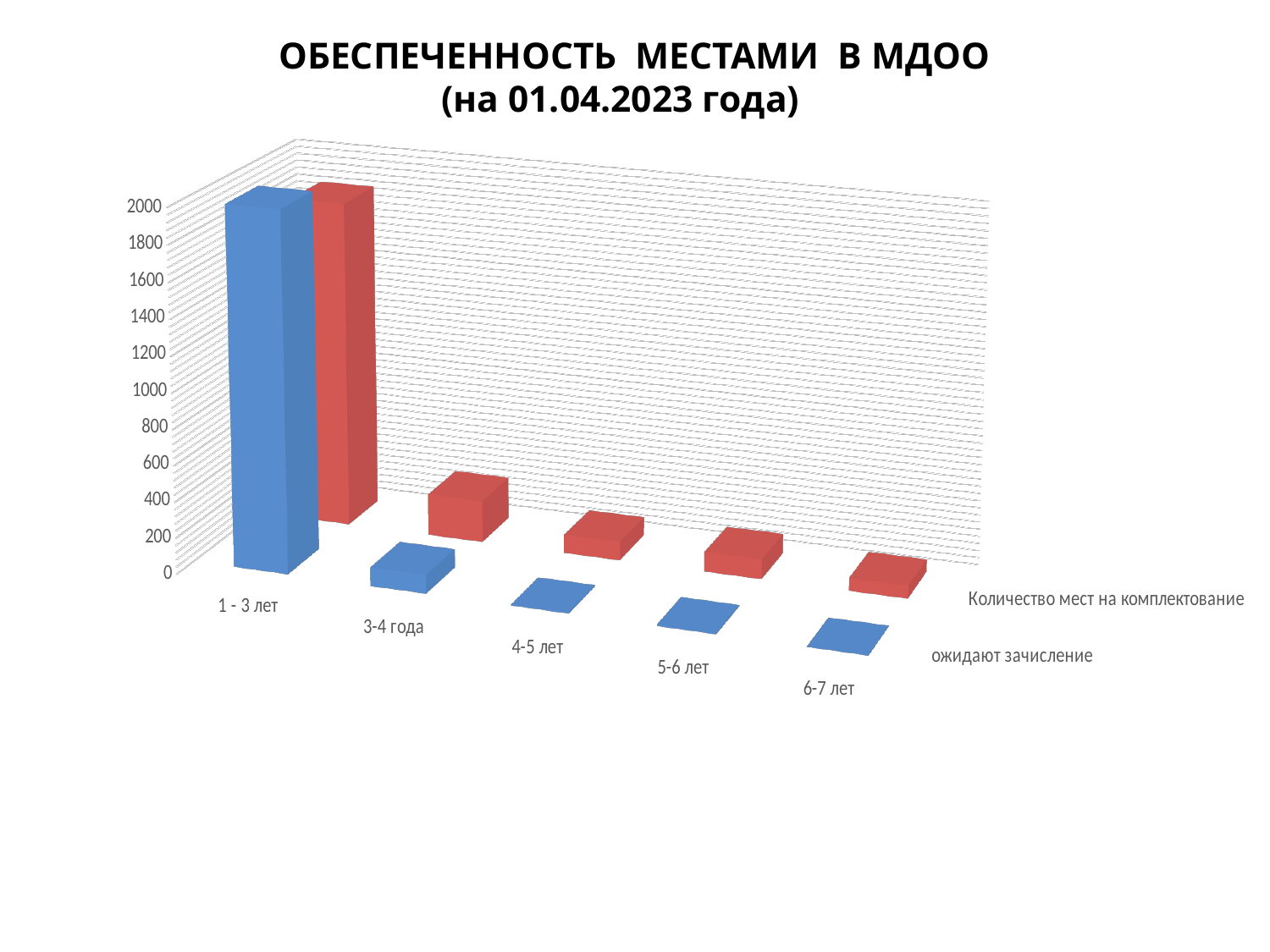
For the series 'Количество мест на комплектование', which is larger: the value for '3-4 года' or for '6-7 лет'? 3-4 года What kind of chart is shown on the slide? bar chart Which age category has the lowest value for the series 'Количество мест на комплектование'? 6-7 лет Do the values for 'Количество мест на комплектование' rise or fall from '1 - 3 лет' to '6-7 лет'? fall What colour are the bars for the series 'ожидают зачисление'? blue Which age category has the highest value for the series 'Количество мест на комплектование'? 1 - 3 лет Which age category has the highest value for the series 'ожидают зачисление'? 1 - 3 лет Is the value for 'Количество мест на комплектование' in the category '3-4 года' greater or less than 1000? less For the series 'ожидают зачисление', which is larger: the value for '1 - 3 лет' or for '3-4 года'? 1 - 3 лет How many age categories are shown on the x axis? 5 Is the value for 'ожидают зачисление' in the category '1 - 3 лет' greater or less than 1000? greater